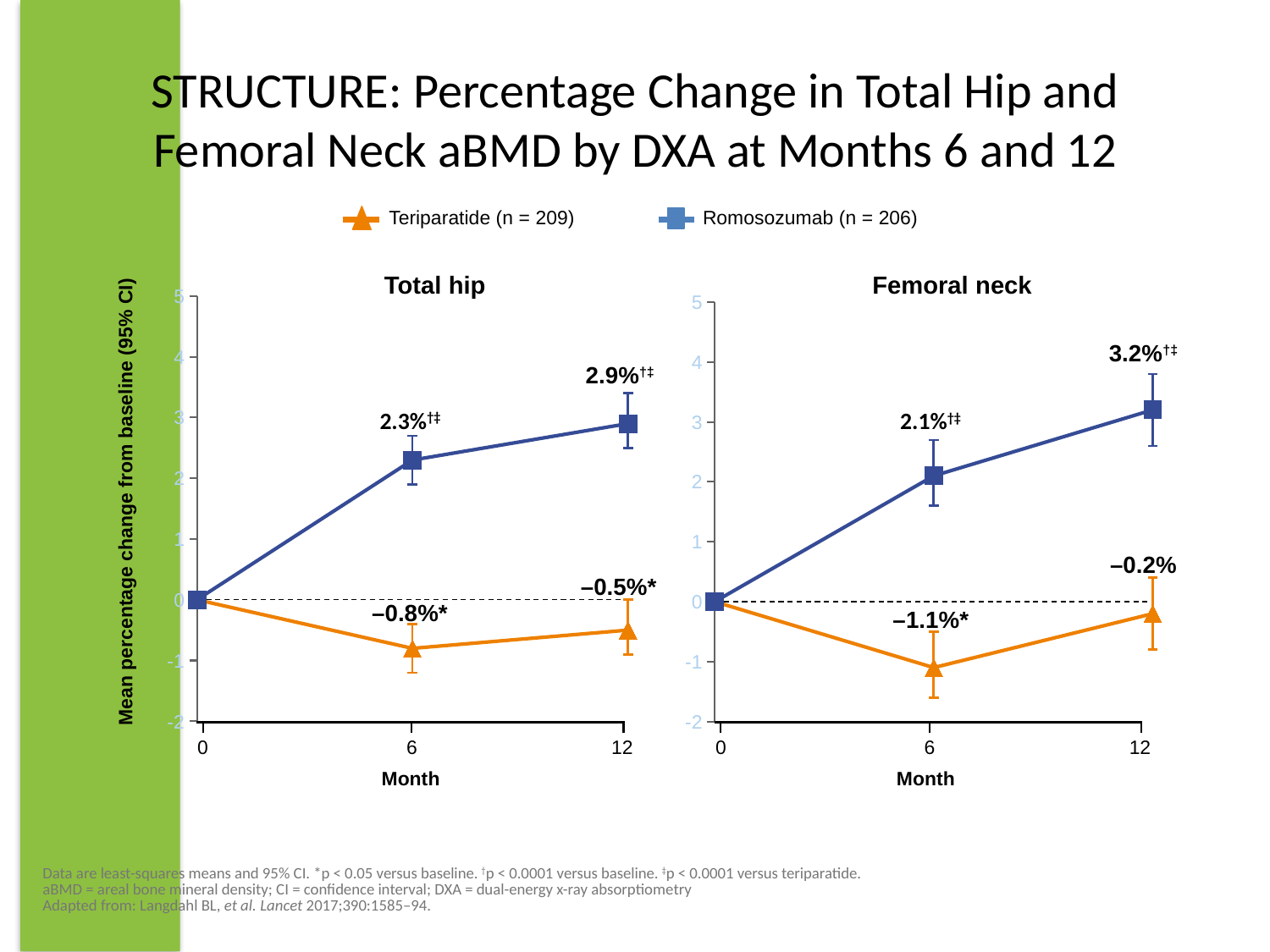
In the Total hip chart, does the Romosozumab series rise or fall from month 0 to month 12? rise In the Femoral neck chart, what is the value for Teriparatide at month 12? –0.2% In the Total hip chart, what is the value for Romosozumab at month 12? 2.9% What is the label of the y axis shared by the two charts? Mean percentage change from baseline (95% CI) In the Femoral neck chart, which series has the higher value at month 12? Romosozumab How many series does the legend list? 2 In the Total hip chart, what is the value for Teriparatide at month 6? –0.8% In the Femoral neck chart, is the Romosozumab value at month 12 greater or less than 3? greater What kind of chart is the Total hip chart? line chart In the Femoral neck chart, what is the value for Romosozumab at month 6? 2.1% In the Femoral neck chart, what is the difference between the Romosozumab and Teriparatide values at month 6? 3.2% In the Total hip chart, what is the difference between the Romosozumab values at month 12 and month 6? 0.6%